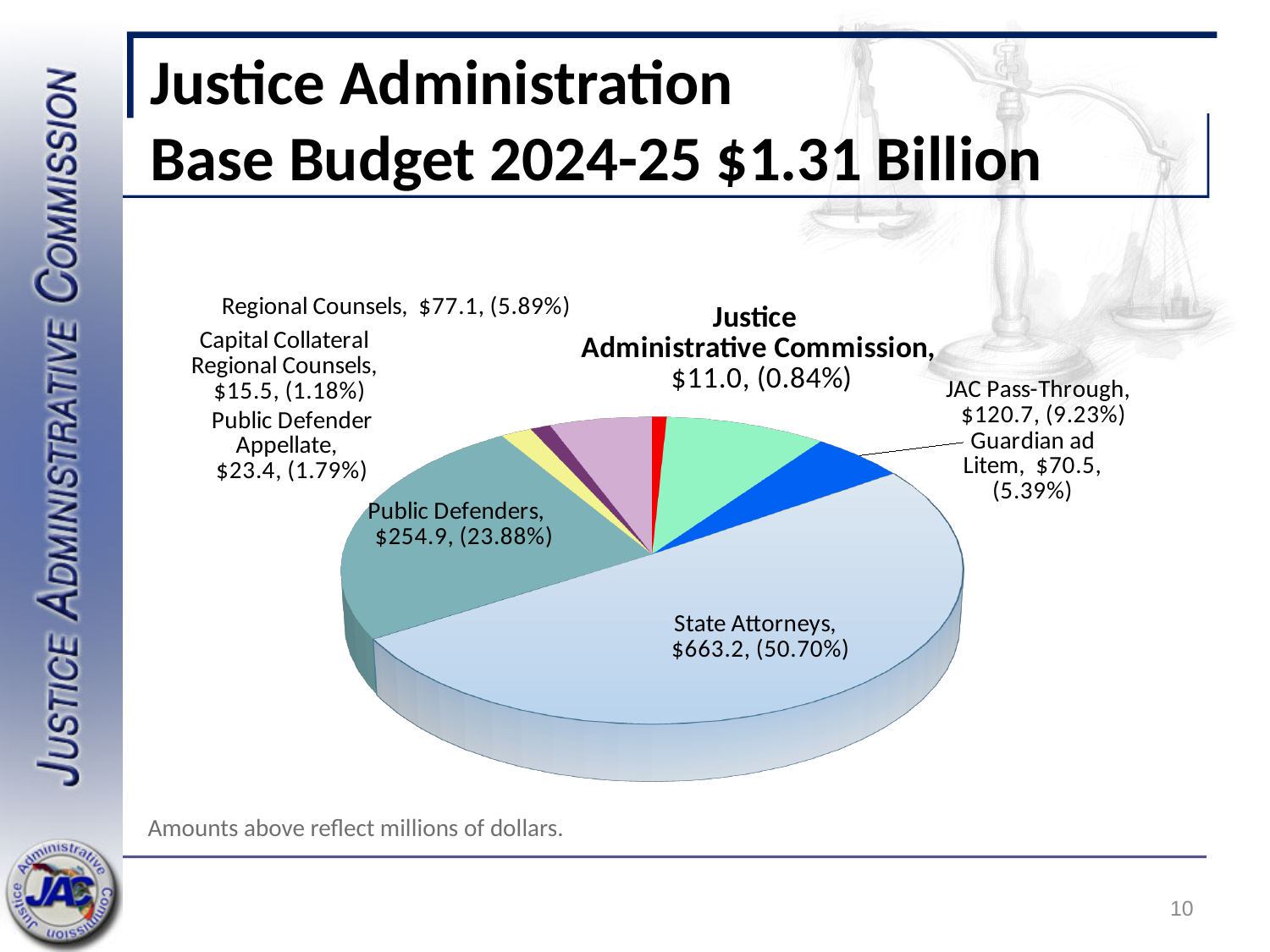
What share of the pie does Regional Counsels represent? 5.89% What is the value for State Attorneys? $663.2 What kind of chart is shown on the slide? pie chart What is the value for Public Defenders? $254.9 Which category has the smallest slice? Justice Administrative Commission How many slices does the pie chart have? 8 According to the note below the chart, what unit are the amounts in? millions of dollars Which category has the largest slice? State Attorneys What is the value for JAC Pass-Through? $120.7 Which is larger, the value for Public Defender Appellate or Capital Collateral Regional Counsels? Public Defender Appellate What share of the pie does Guardian ad Litem represent? 5.39% What is the difference between the values for State Attorneys and Public Defenders? $408.3